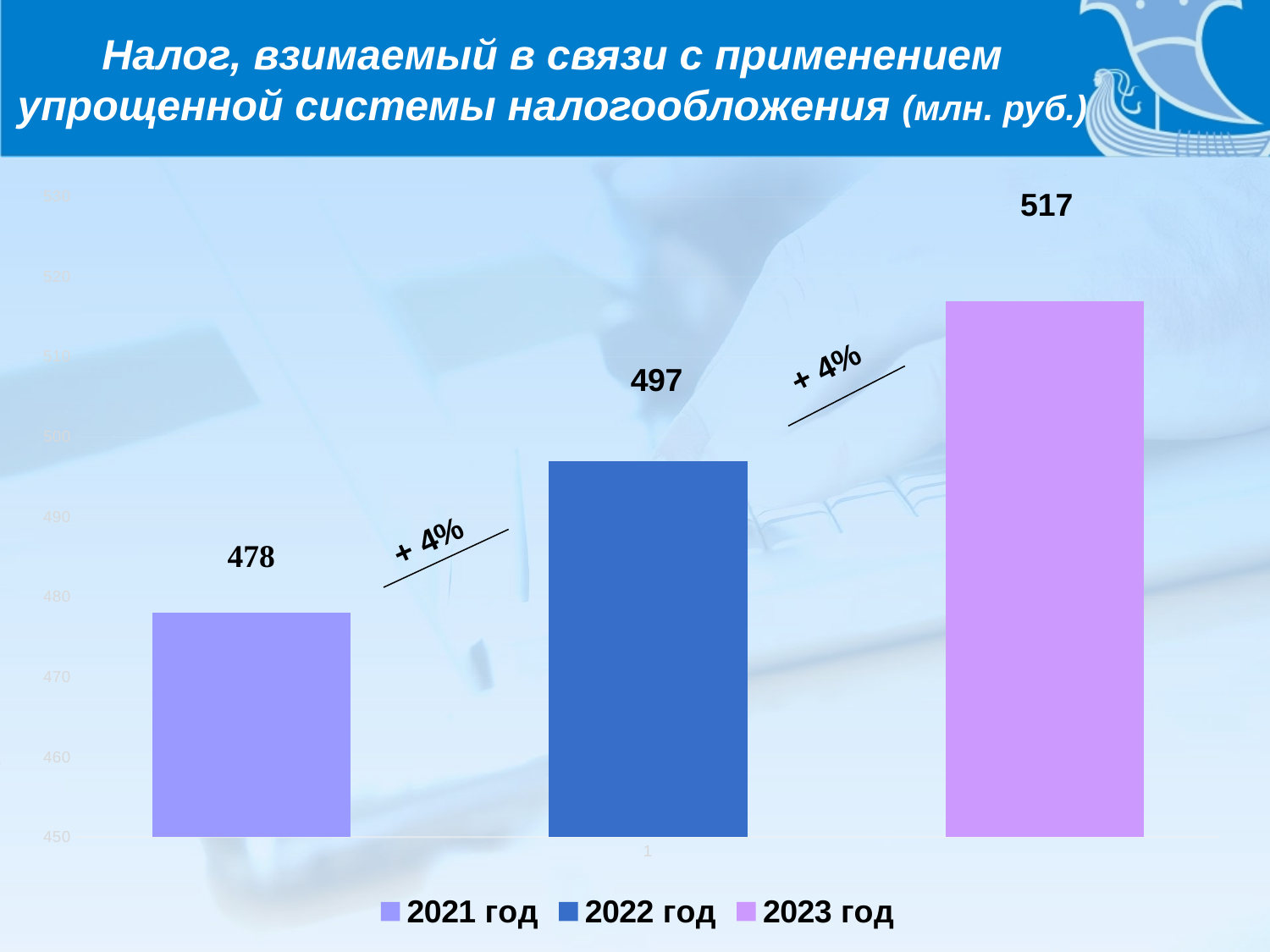
Which year has the highest value? 2023 год What percentage change is annotated between the 2022 год and 2023 год bars? + 4% What is the difference between the values for 2022 год and 2021 год? 19 Which is larger, the value for 2022 год or the value for 2023 год? 2023 год What kind of chart is shown on the slide? bar chart What is the value for 2021 год? 478 What is the value for 2022 год? 497 What is the difference between the values for 2023 год and 2021 год? 39 Do the values rise or fall from 2021 год to 2023 год? rise Which year has the lowest value? 2021 год How many series does the legend list? 3 What is the value for 2023 год? 517